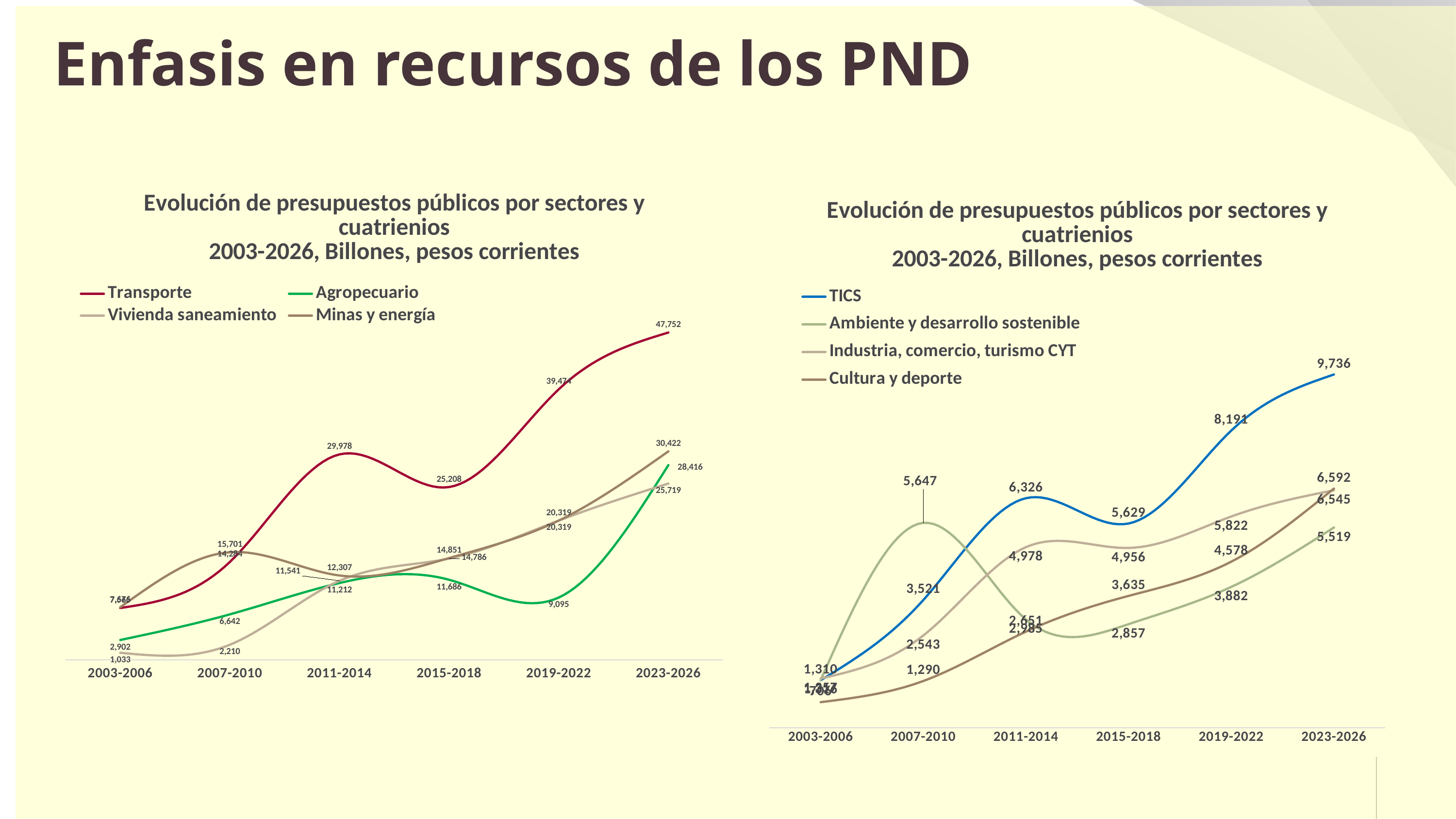
In the left chart, what is the value for Transporte in 2011-2014? 29,978 In the right chart, what is the value for Ambiente y desarrollo sostenible in 2007-2010? 5,647 In the left chart, what is the value for Minas y energía in 2023-2026? 30,422 In the left chart, what is the difference between the Transporte values for 2023-2026 and 2019-2022? 8,278 In the left chart, what is the value for Transporte in 2023-2026? 47,752 In the left chart, what is the value for Agropecuario in 2019-2022? 9,095 In the right chart, what is the value for TICS in 2023-2026? 9,736 In the left chart, which series has the highest value in 2023-2026? Transporte In the right chart, what is the difference between the TICS values for 2023-2026 and 2019-2022? 1,545 How many series does the legend of the right chart list? 4 What kind of chart is the left chart? Line chart In the right chart, what is the value for Cultura y deporte in 2023-2026? 6,592